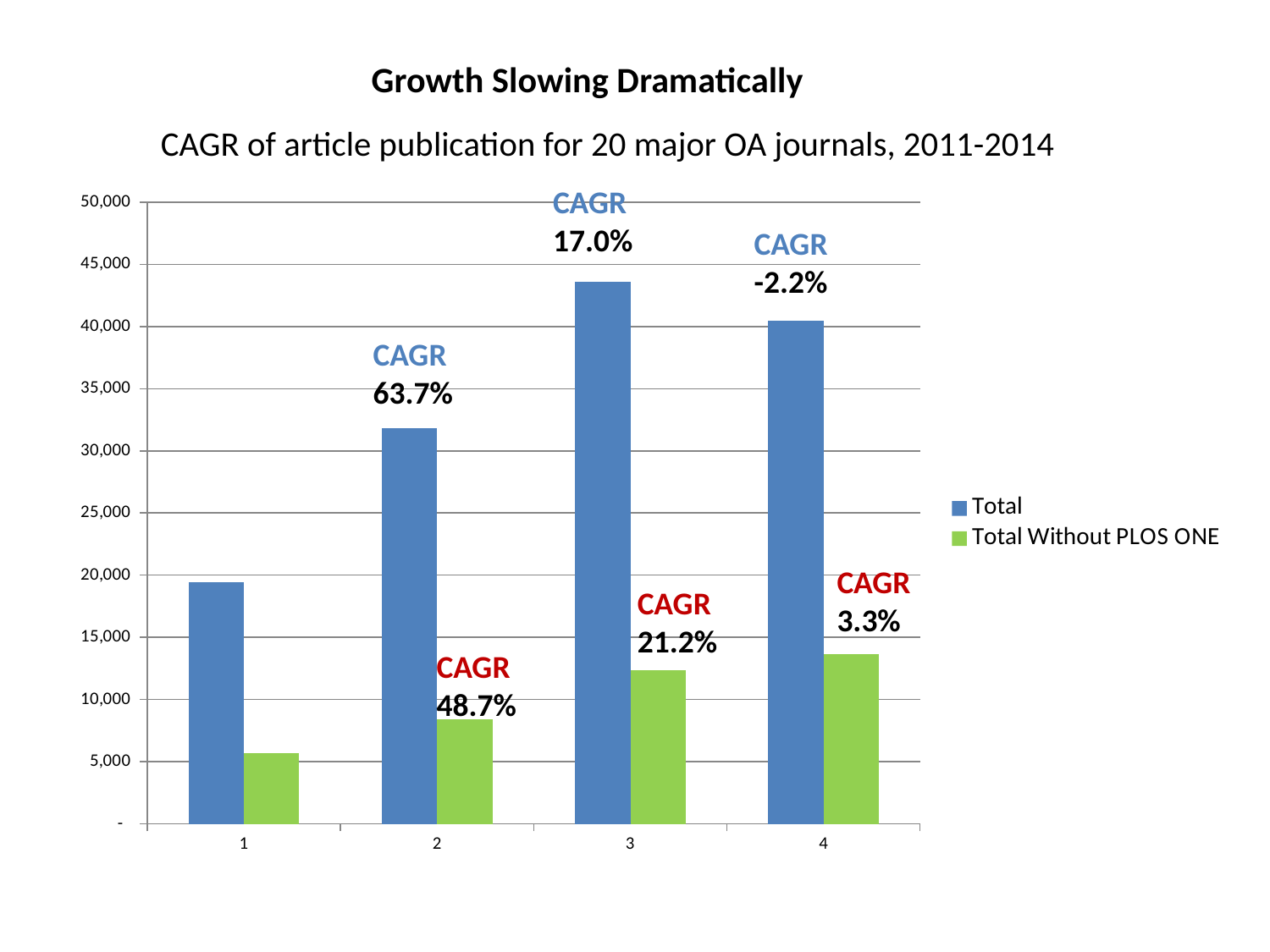
What CAGR is annotated above the Total Without PLOS ONE bar for category 4? 3.3% Is the Total value for category 3 greater or less than 40,000? greater Which is larger, the Total value for category 2 or the Total value for category 4? category 4 For which category is the Total Without PLOS ONE series lowest? 1 What kind of chart is shown on the slide? bar chart Do the Total Without PLOS ONE values rise or fall from category 1 to category 4? rise For which category is the Total series lowest? 1 How many series does the legend list? 2 What CAGR is annotated above the Total bar for category 2? 63.7% How many categories are shown on the x axis? 4 For which category is the Total series highest? 3 Is the Total Without PLOS ONE value for category 1 greater or less than 10,000? less